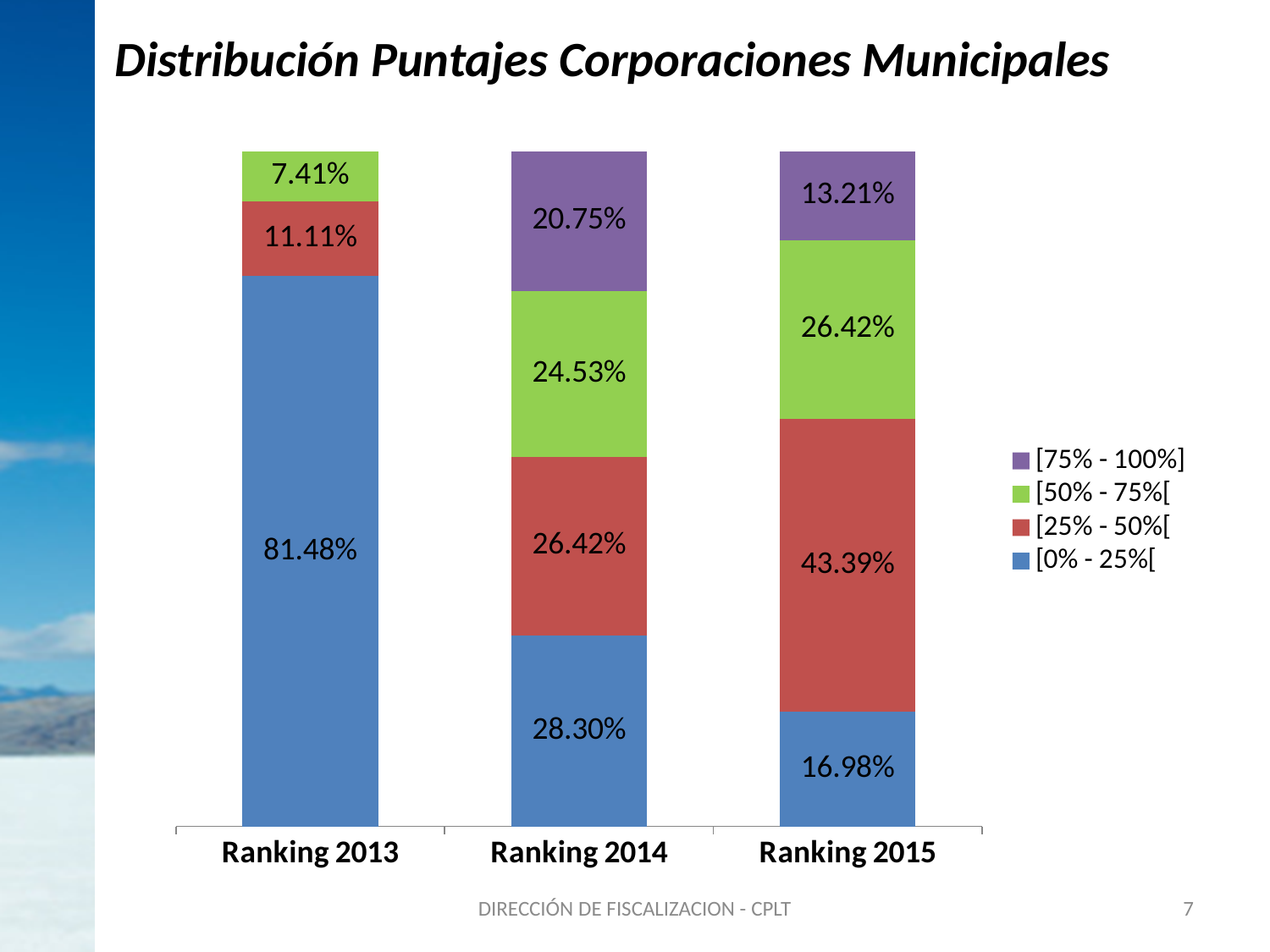
How many series does the legend list? 4 What is the difference between the [0% - 25%[ values for Ranking 2014 and Ranking 2015? 11.32% Which is larger: the [25% - 50%[ value for Ranking 2014 or for Ranking 2015? Ranking 2015 What is the value of the [50% - 75%[ segment for Ranking 2013? 7.41% How many ranking years are shown on the x axis? 3 What is the value of the [75% - 100%] segment for Ranking 2014? 20.75% What is the value of the [0% - 25%[ segment for Ranking 2013? 81.48% What is the value of the [25% - 50%[ segment for Ranking 2015? 43.39% What kind of chart is shown on the slide? stacked bar chart Does the [0% - 25%[ value rise or fall from Ranking 2013 to Ranking 2015? fall Which ranking year has the lowest [0% - 25%[ value? Ranking 2015 Which ranking year has the highest [0% - 25%[ value? Ranking 2013